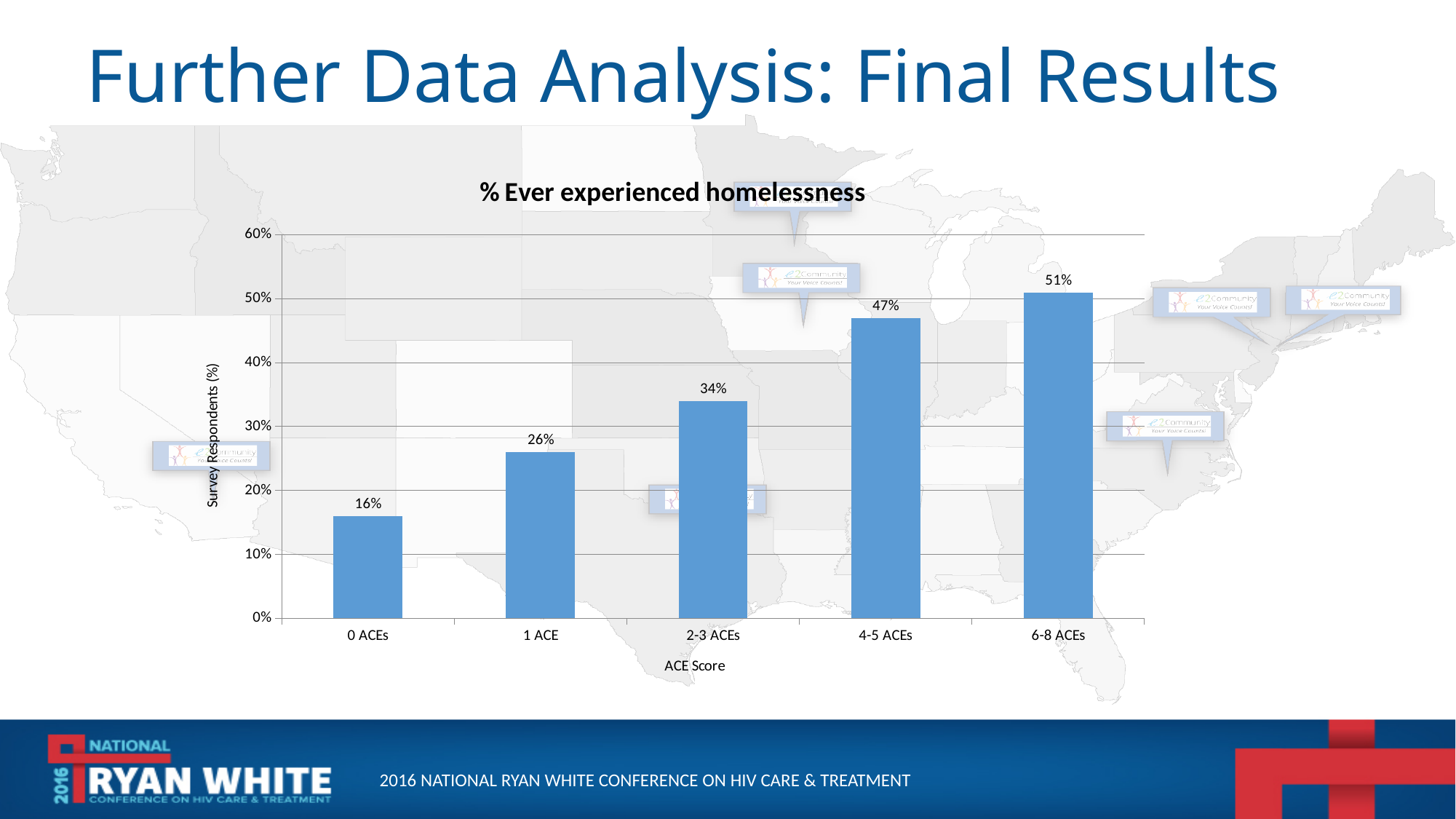
Which ACE score category has the lowest percentage of respondents who ever experienced homelessness? 0 ACEs What is the difference in percentage points between the 6-8 ACEs and 0 ACEs categories? 35 percentage points What is the difference between the values for 1 ACE and 2-3 ACEs? 8 percentage points What kind of chart is shown on the slide? Bar chart Do the values rise or fall as the ACE score increases along the x axis? Rise What is the value shown for the 2-3 ACEs category? 34% What is the value shown for the 4-5 ACEs category? 47% Which ACE score category has the highest percentage of respondents who ever experienced homelessness? 6-8 ACEs What percentage of survey respondents with 0 ACEs ever experienced homelessness? 16% How many ACE score categories are shown on the x axis? 5 Is the value for 6-8 ACEs greater or less than 50%? greater Which is larger, the value for 1 ACE or the value for 4-5 ACEs? 4-5 ACEs